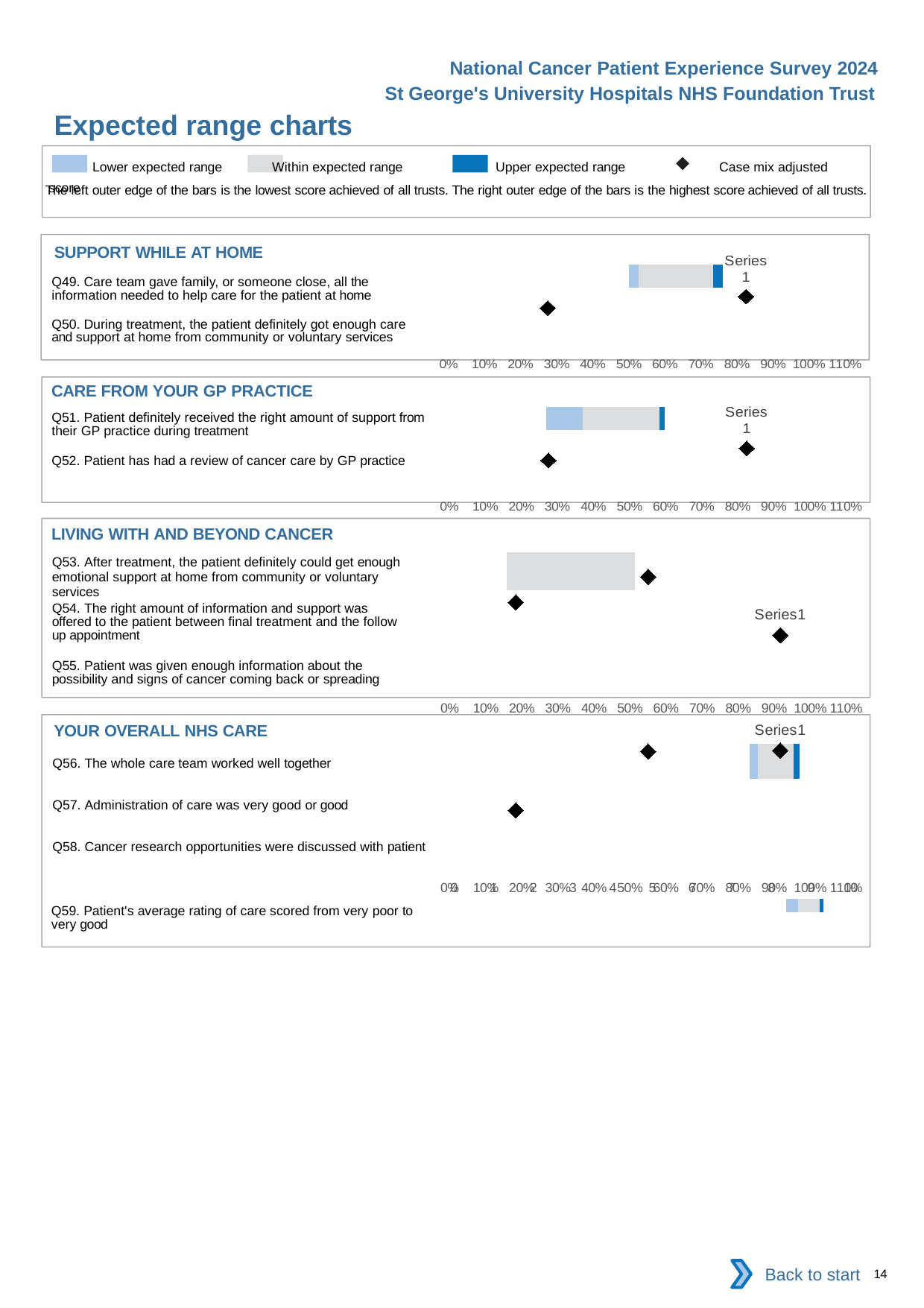
In the LIVING WITH AND BEYOND CANCER chart, is the right edge of the expected range bar greater or less than 40%? greater How many questions (categories) are listed in the LIVING WITH AND BEYOND CANCER section? 3 How many questions (categories) are listed in the SUPPORT WHILE AT HOME section? 2 In the YOUR OVERALL NHS CARE chart, is the left edge of the expected range bar greater or less than 80%? greater What kind of chart is used in the SUPPORT WHILE AT HOME section? bar chart How many entries does the legend at the top of the slide list? 4 In the CARE FROM YOUR GP PRACTICE chart, is the right edge of the expected range bar greater or less than 70%? less What is the highest value shown on the x axis of the CARE FROM YOUR GP PRACTICE chart? 110% How many questions (categories) are listed in the YOUR OVERALL NHS CARE section? 4